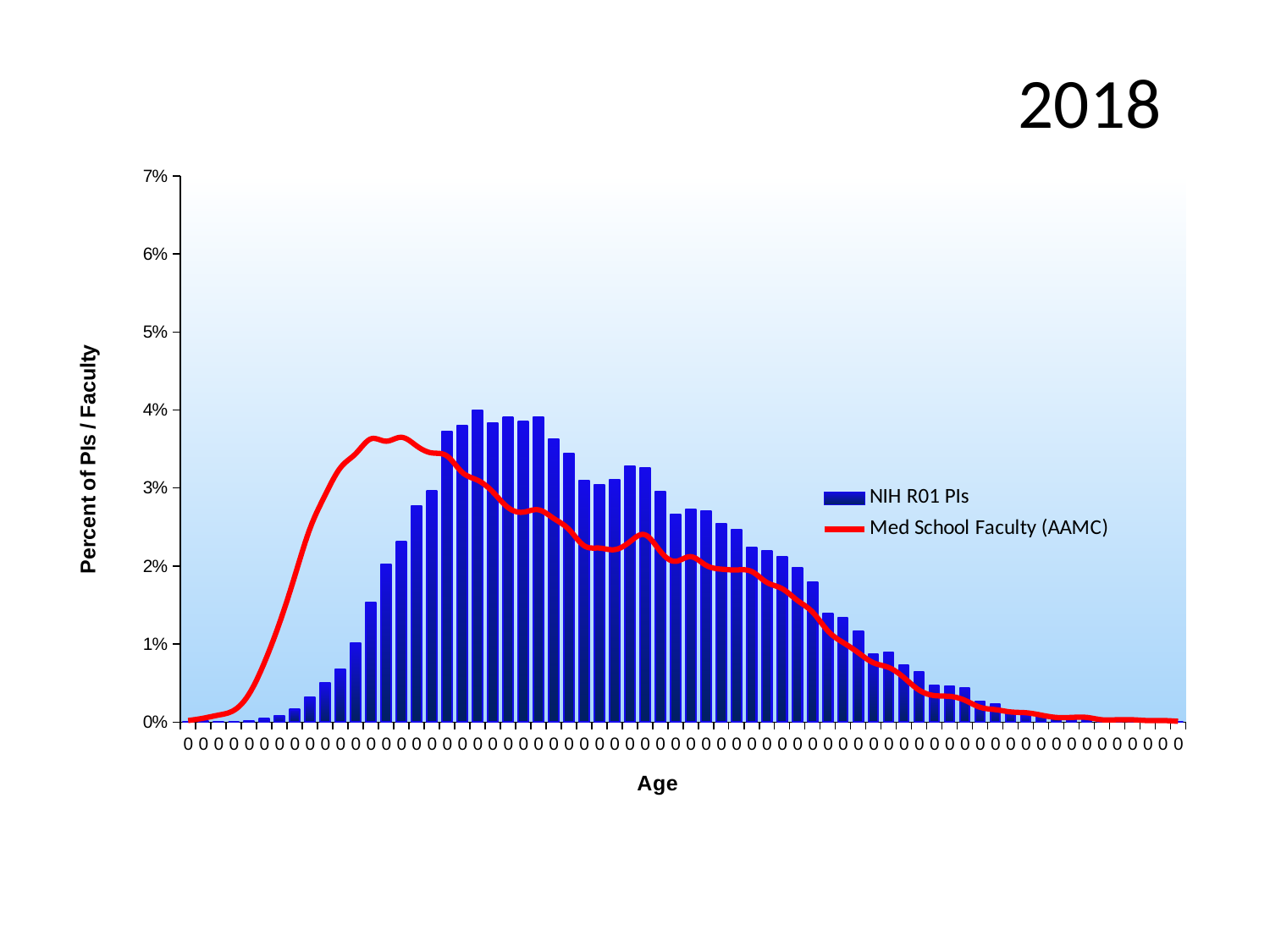
How many series does the legend list? 2 Which series reaches the higher peak value, NIH R01 PIs or Med School Faculty (AAMC)? NIH R01 PIs Do the NIH R01 PIs bars rise or fall toward the right end of the x axis? fall Is the peak of the Med School Faculty (AAMC) line greater or less than 3%? greater Is the peak of the Med School Faculty (AAMC) line greater or less than 4%? less Does the Med School Faculty (AAMC) line rise or fall over the right half of the chart? fall What are the two series named in the legend? NIH R01 PIs and Med School Faculty (AAMC) What kind of chart is used to plot the NIH R01 PIs series? bar chart Is the tallest NIH R01 PIs bar greater or less than 3%? greater What is the title of the vertical axis? Percent of PIs / Faculty